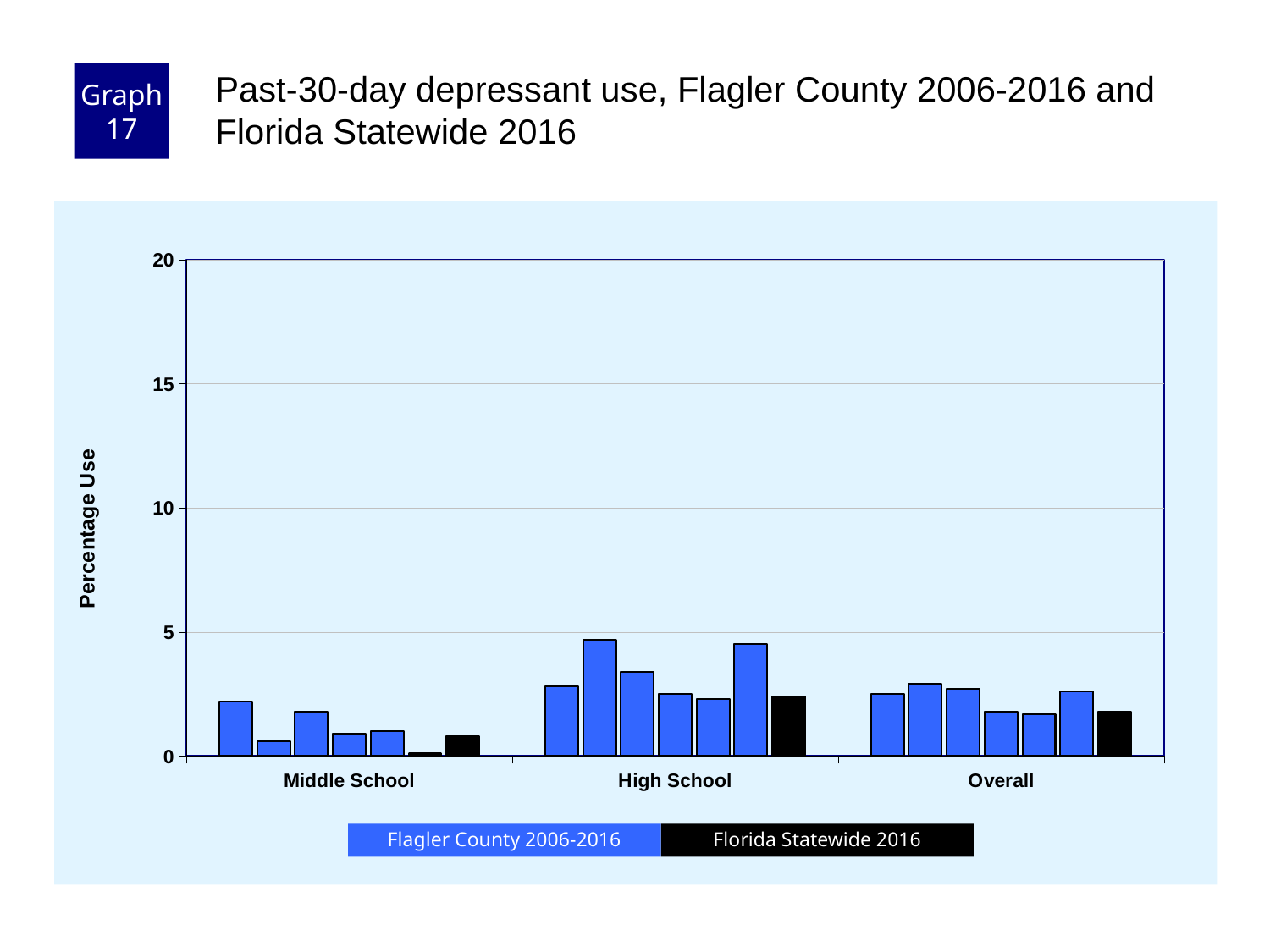
Which category group contains the tallest bar on the chart? High School Which is larger, the Florida Statewide 2016 bar for Overall or for Middle School? Overall Which category group contains the shortest bar on the chart? Middle School How many category groups are shown on the x axis? 3 How many series does the legend list? 2 How many bars are plotted in the High School group? 7 Is the tallest Flagler County 2006-2016 bar in the Overall group greater or less than 5? less What kind of chart is shown on the slide? bar chart Is the Florida Statewide 2016 value for Middle School greater or less than 5? less Which is larger, the Florida Statewide 2016 bar for Middle School or for High School? High School What is the label on the y axis? Percentage Use Is the Florida Statewide 2016 value for High School greater or less than 5? less